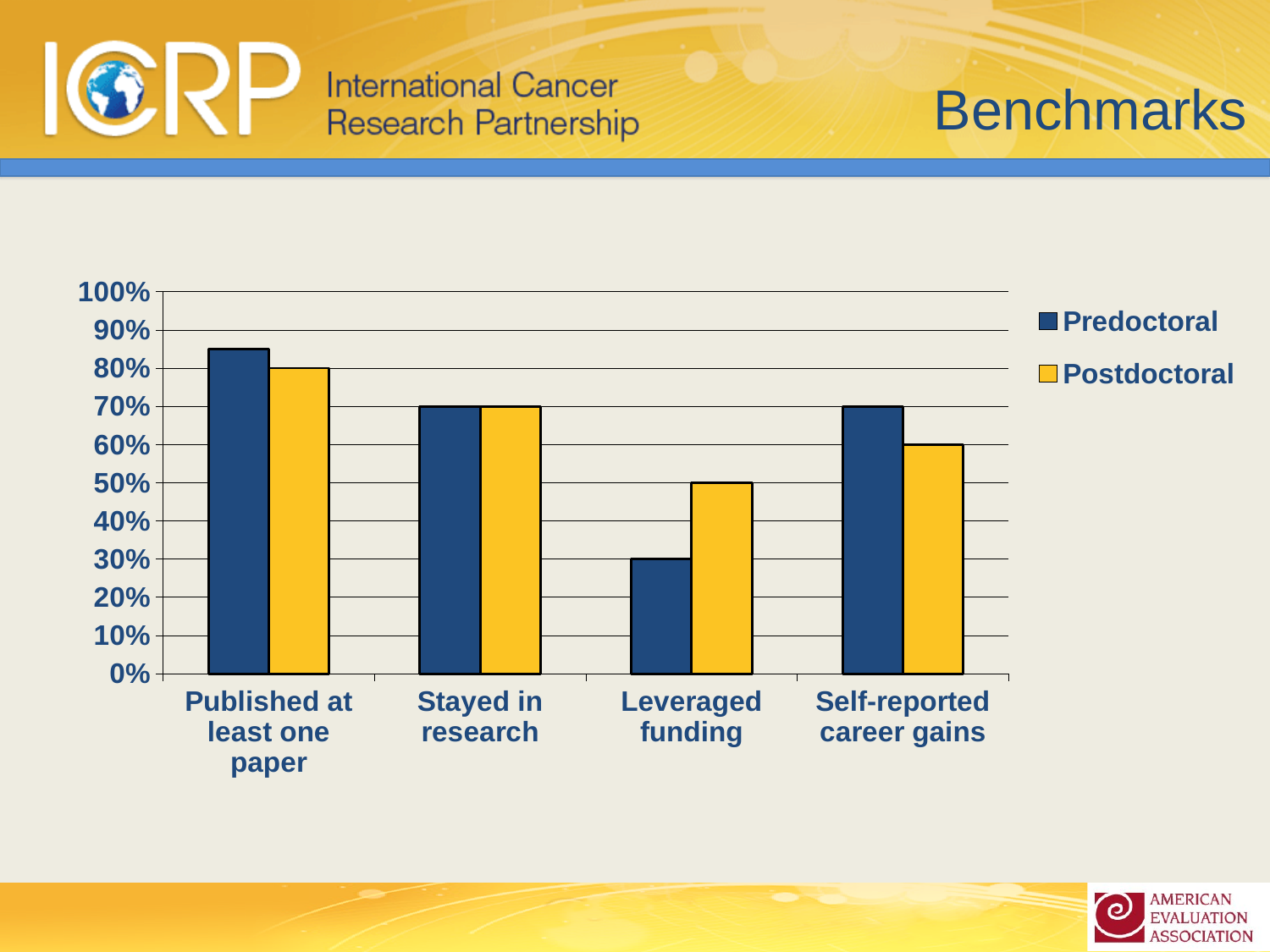
What is the Predoctoral value for Leveraged funding? 30% What is the Postdoctoral value for Self-reported career gains? 60% What is the Postdoctoral value for Leveraged funding? 50% What is the Postdoctoral value for Published at least one paper? 80% What is the difference between the Postdoctoral and Predoctoral values for Leveraged funding? 20% Which category has the lowest Predoctoral value? Leveraged funding Is the Predoctoral value for Published at least one paper greater or less than 80%? greater Which category has the highest Postdoctoral value? Published at least one paper How many series does the legend list? 2 What kind of chart is shown on the slide? bar chart For Leveraged funding, which is larger, the Predoctoral or the Postdoctoral value? Postdoctoral How many categories are shown on the x axis? 4